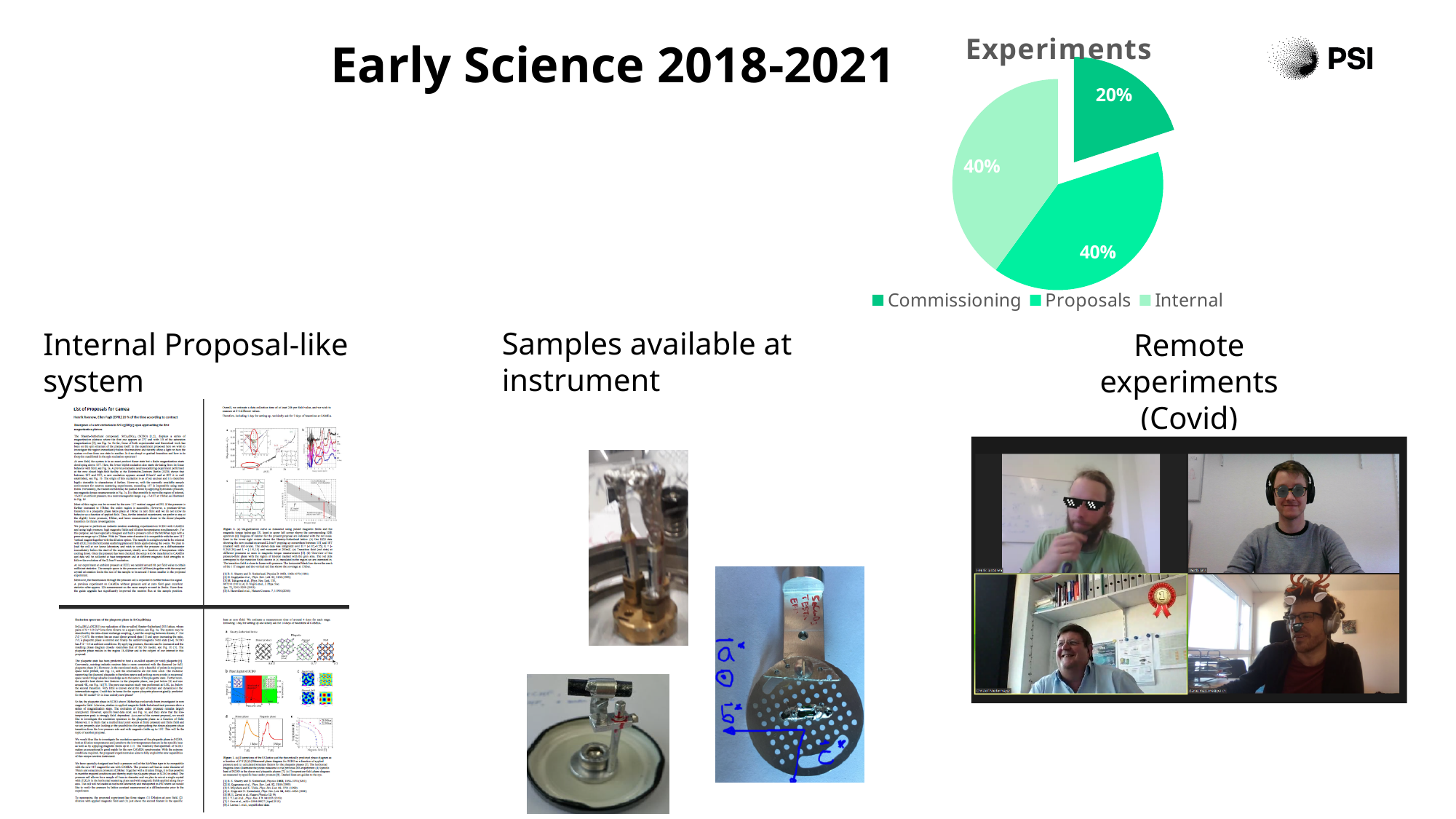
What kind of chart is shown under the title "Experiments"? pie chart What percentage of the Experiments pie is Proposals? 40% What share of the Experiments pie does the Internal slice represent? 40% Which category has the smallest slice in the Experiments pie chart? Commissioning In the Experiments pie chart, what is the difference between the Proposals share and the Commissioning share? 20% In the Experiments pie chart, which is larger: Commissioning or Proposals? Proposals Which slice of the Experiments pie chart is pulled out (exploded) from the rest of the pie? Commissioning What is the title of the pie chart on the slide? Experiments How many slices does the Experiments pie chart have? 3 What percentage of the Experiments pie is Internal? 40% How many entries does the legend of the Experiments pie chart list? 3 What percentage of the Experiments pie is Commissioning? 20%